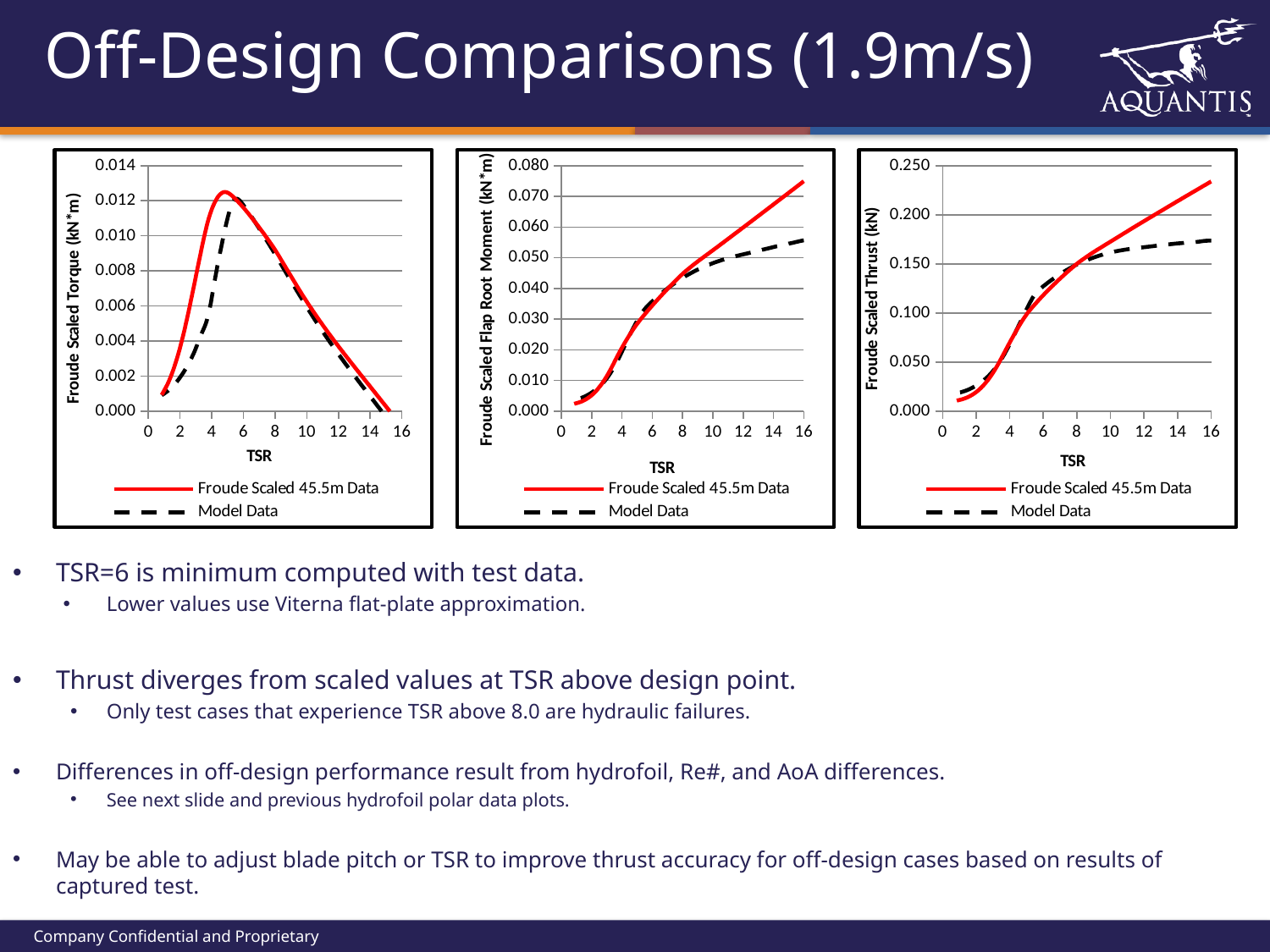
In the Froude Scaled Flap Root Moment chart, is the Froude Scaled 45.5m Data value at TSR 16 greater or less than 0.070? greater In the Froude Scaled Thrust chart, is the Froude Scaled 45.5m Data value at TSR 16 greater or less than 0.200? greater In the Froude Scaled Flap Root Moment chart, is the Model Data value at TSR 16 greater or less than 0.060? less In the Froude Scaled Flap Root Moment chart, which series is drawn as a dashed black line? Model Data What kind of chart is the leftmost chart (Froude Scaled Torque vs TSR)? Line chart How many charts are shown on the slide? 3 In the Froude Scaled Thrust chart, how many series does the legend list? 2 In the Froude Scaled Thrust chart, does the Froude Scaled 45.5m Data series rise or fall as TSR increases? Rise In the Froude Scaled Thrust chart, which series has the higher value at TSR 16, Froude Scaled 45.5m Data or Model Data? Froude Scaled 45.5m Data What is the x-axis label on the Froude Scaled Torque chart? TSR